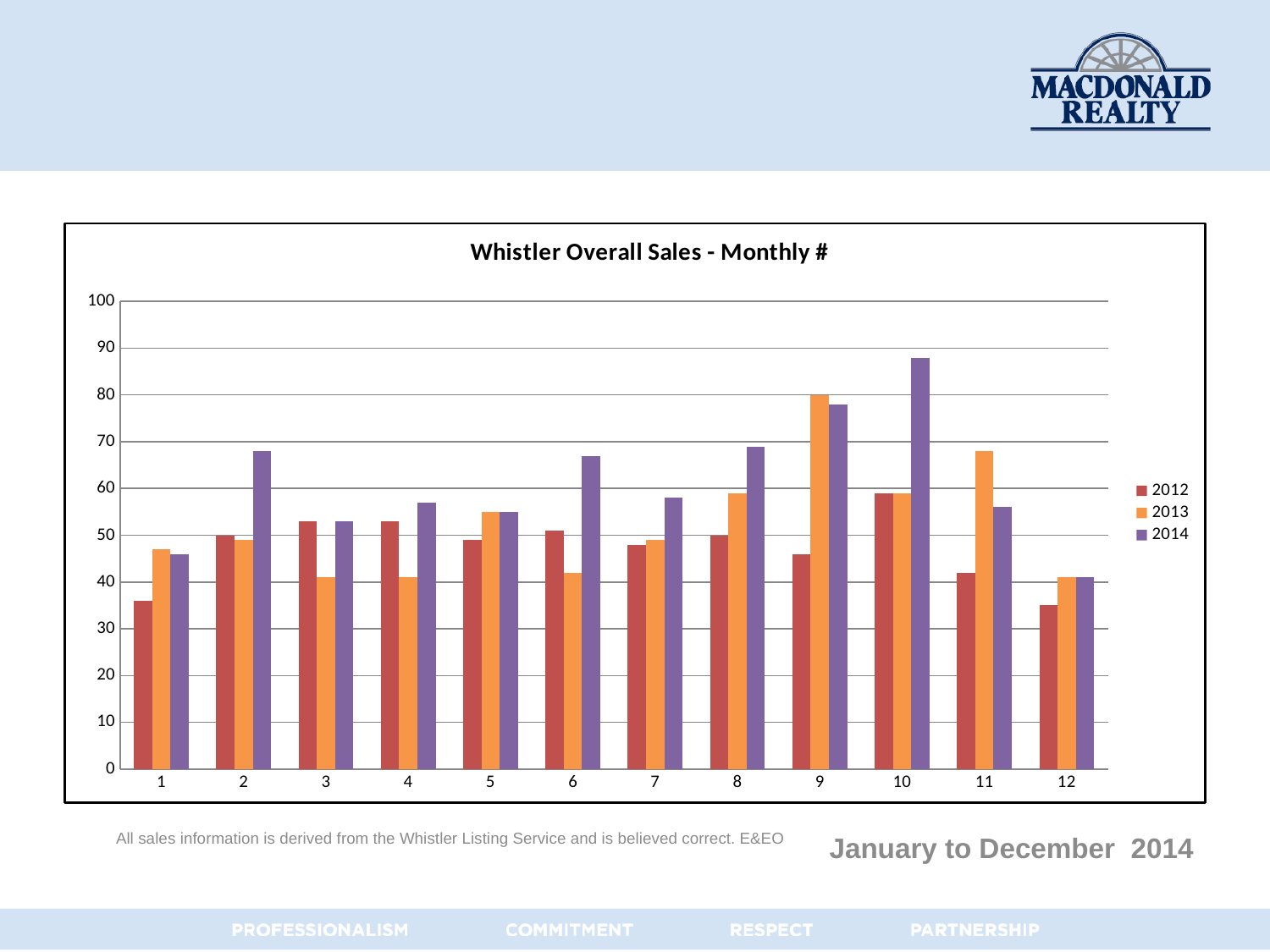
In month 6, which series has the larger value, 2013 or 2014? 2014 Is the 2014 value for month 10 greater or less than 80? greater Which month has the highest value for the 2012 series? 10 Which month has the highest value for the 2014 series? 10 How many series does the legend list? 3 Is the 2012 value for month 1 greater or less than 40? less Is the 2014 value for month 2 greater or less than 60? greater What is the title of the chart? Whistler Overall Sales - Monthly # What kind of chart is shown on the slide? bar chart How many months (categories) are shown on the x axis? 12 Which month has the highest value for the 2013 series? 9 In month 11, which series has the larger value, 2013 or 2014? 2013